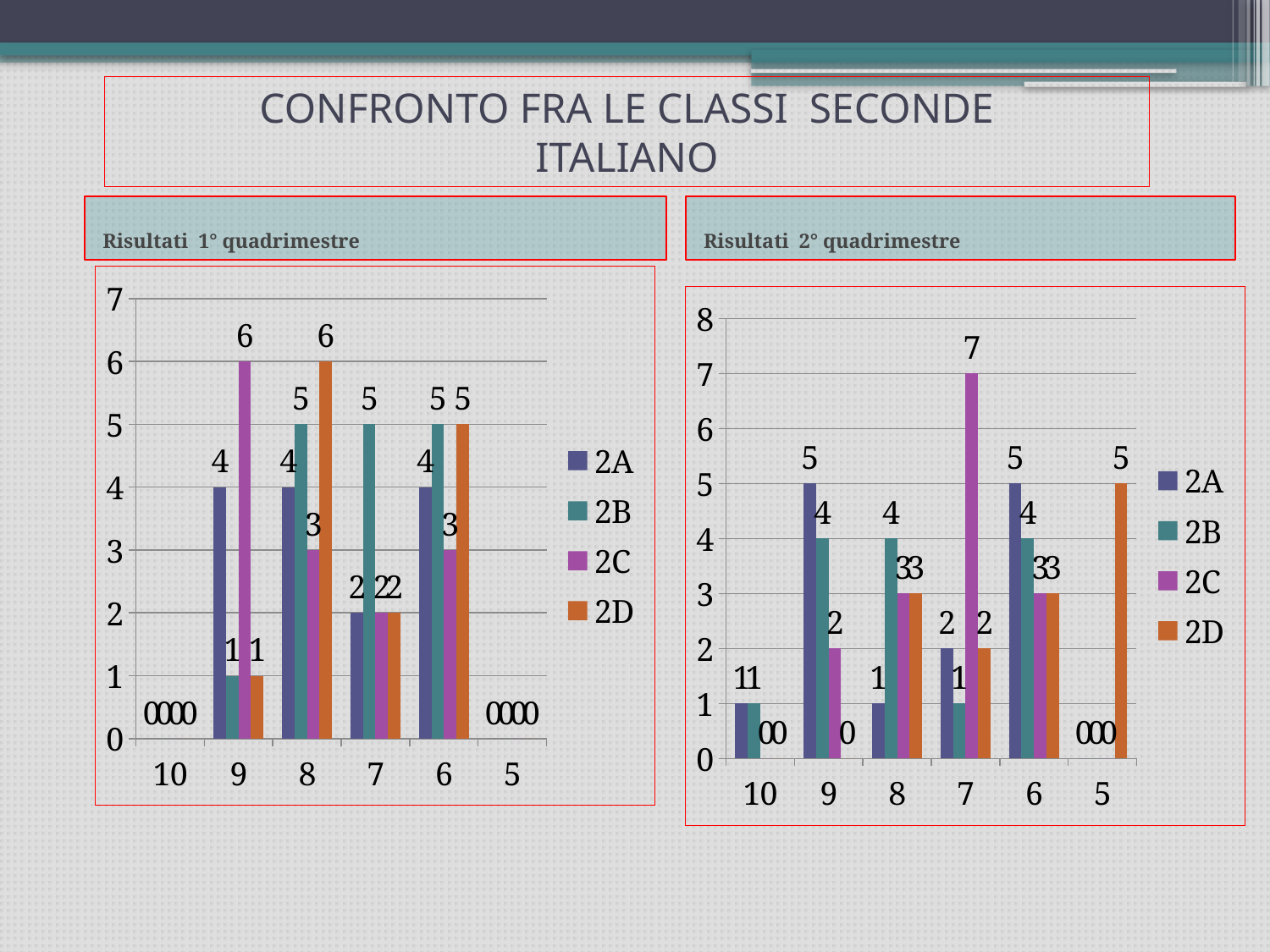
What kind of chart is the 'Risultati 1° quadrimestre' chart? Bar chart In the 'Risultati 2° quadrimestre' chart, what is the difference between 2B and 2A at category 8? 3 How many categories are shown on the x axis of the 'Risultati 2° quadrimestre' chart? 6 In the 'Risultati 2° quadrimestre' chart, what is the value for 2D at category 5? 5 In the 'Risultati 2° quadrimestre' chart, what is the value for 2C at category 7? 7 In the 'Risultati 1° quadrimestre' chart, what is the difference between 2B and 2C at category 6? 2 In the 'Risultati 2° quadrimestre' chart, which is larger at category 9: 2A or 2C? 2A In the 'Risultati 1° quadrimestre' chart, what is the value for 2D at category 8? 6 In the 'Risultati 1° quadrimestre' chart, what is the value for 2C at category 9? 6 In the 'Risultati 1° quadrimestre' chart, what is the value for 2B at category 7? 5 In the 'Risultati 2° quadrimestre' chart, which series has the highest value at category 7? 2C In the 'Risultati 1° quadrimestre' chart, how many series does the legend list? 4